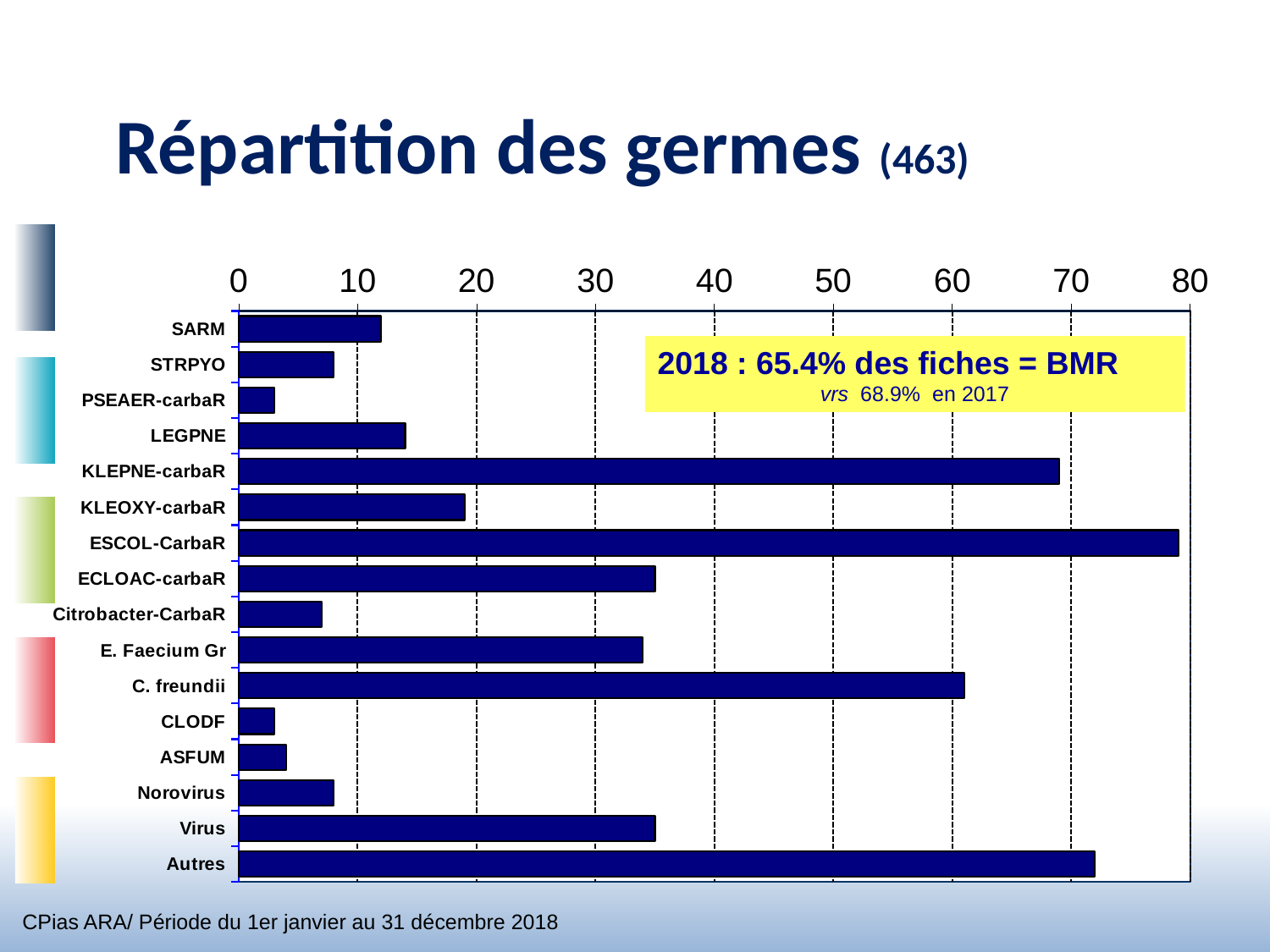
Is the value for C. freundii greater or less than 50? greater What is the title of the chart on the slide? Répartition des germes (463) Which category has the highest value on the chart? ESCOL-CarbaR Which is larger, the value for KLEPNE-carbaR or the value for C. freundii? KLEPNE-carbaR What kind of chart is shown on the slide? bar chart How many categories (germs) are plotted on the chart? 16 Which is larger, the value for E. Faecium Gr or the value for Citrobacter-CarbaR? E. Faecium Gr Is the value for ECLOAC-carbaR greater or less than 30? greater Is the value for Citrobacter-CarbaR greater or less than 10? less